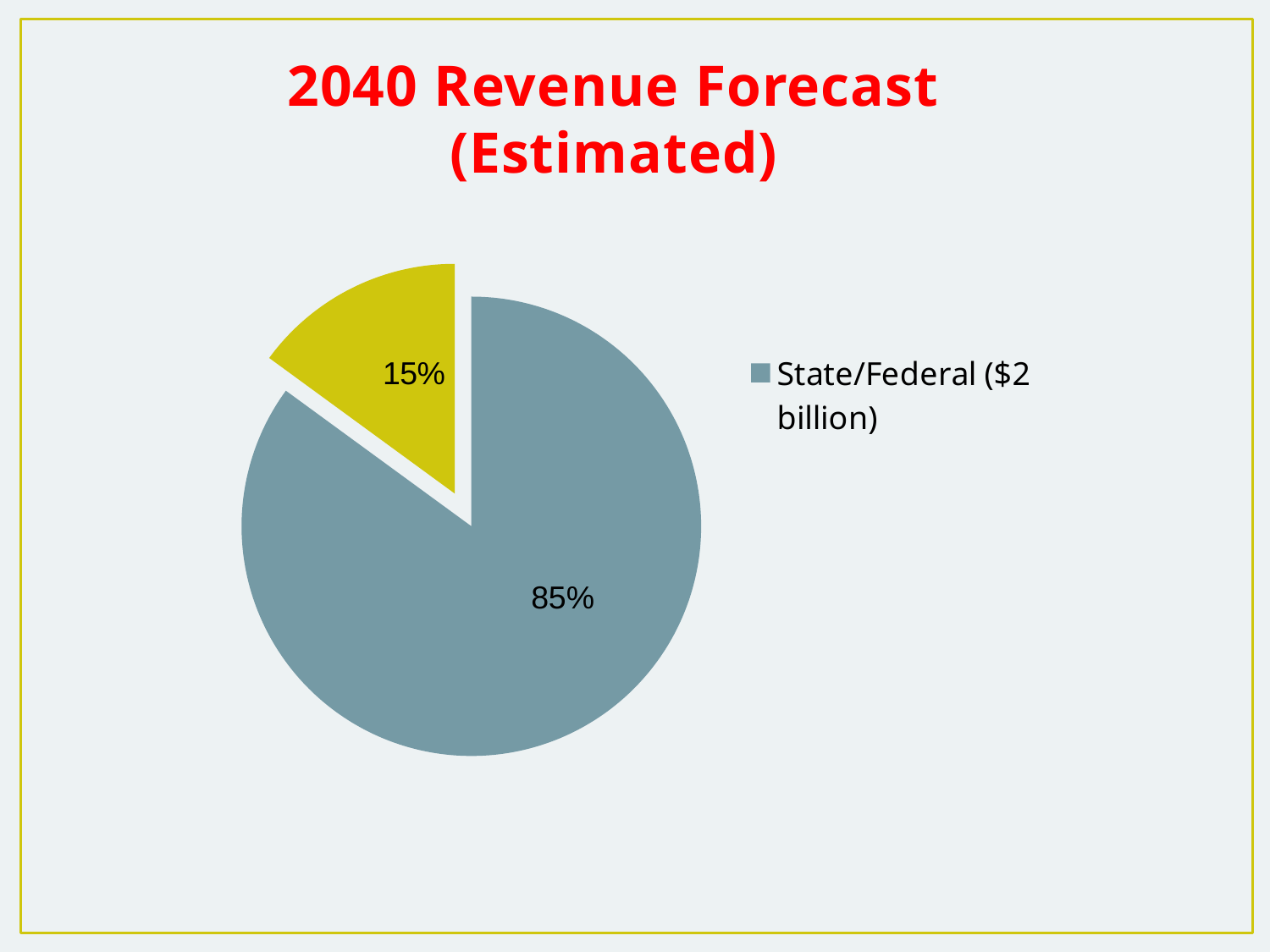
What share of the pie does State/Federal ($2 billion) represent? 85% Which is larger, the State/Federal slice or the yellow slice? State/Federal slice How many slices does the pie chart have? 2 What percentage is shown on the yellow slice of the pie? 15% How many entries does the legend list? 1 What is the percentage of the smallest slice in the pie chart? 15% What is the difference in percentage points between the 85% slice and the 15% slice? 70 What kind of chart is shown on the slide? pie chart Is the share of the State/Federal slice greater or less than 50%? greater Which slice is the largest in the pie chart? State/Federal ($2 billion) What is the title of the chart? 2040 Revenue Forecast (Estimated) What dollar amount is given in the legend for State/Federal? $2 billion